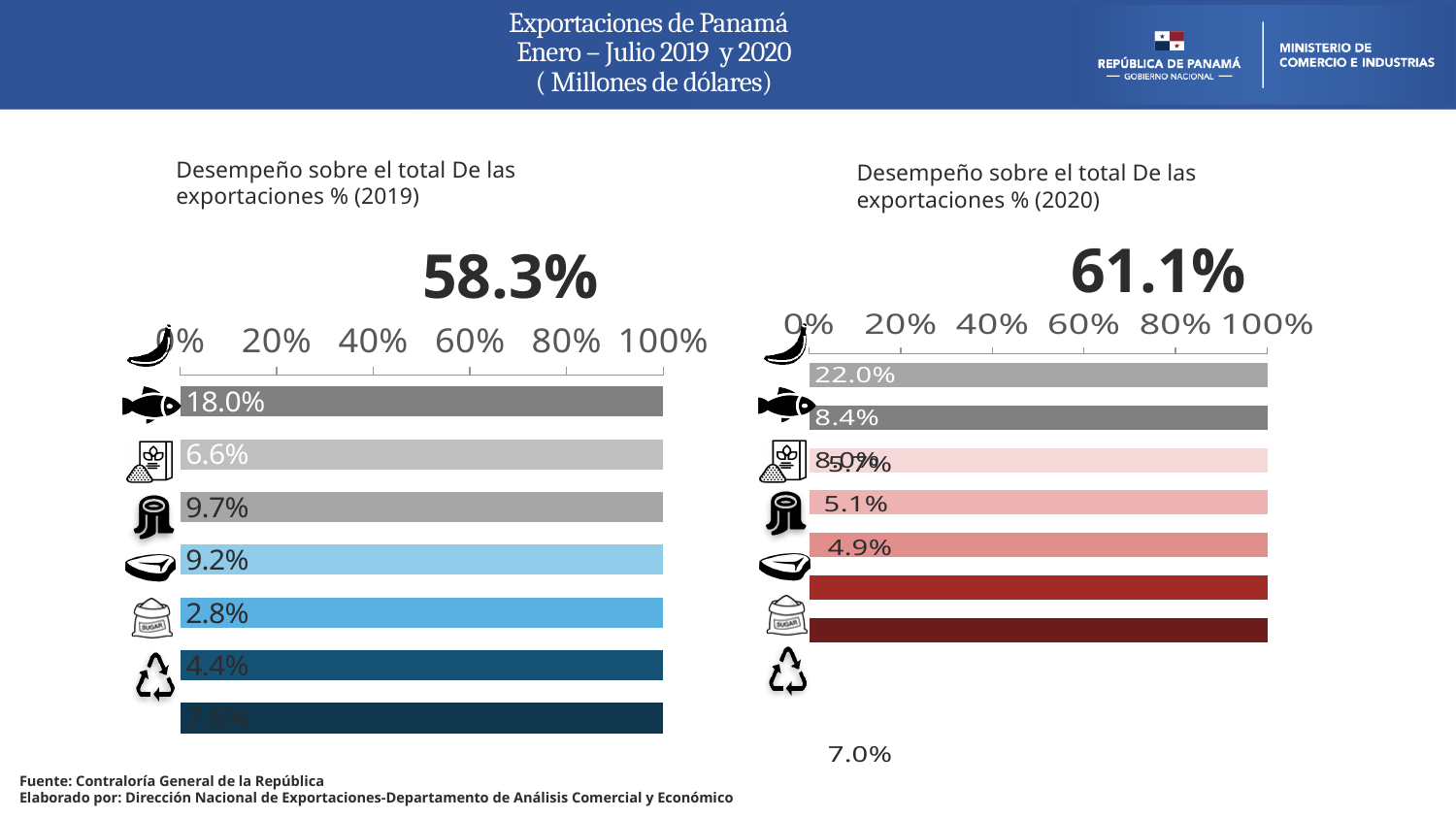
In the 2019 chart on the left, which bar has the lowest labelled value? the bar next to the sugar sack icon, 2.8% In the 2020 chart on the right, what is the data label on the second bar from the top? 8.4% In the 2019 chart on the left, what is the data label on the bar next to the sugar sack icon? 2.8% In the 2019 chart on the left, what is the data label on the topmost bar? 18.0% In the 2020 chart on the right, what is the data label on the topmost bar? 22.0% What kind of chart is used on the left side of the slide for 'Desempeño sobre el total De las exportaciones % (2019)'? bar chart In the 2019 chart on the left, what is the data label on the bar next to the recycling icon? 4.4% In the 2019 chart on the left, what is the difference between the topmost bar's value (18.0%) and the value next to the sugar sack icon (2.8%)? 15.2 percentage points Which is larger: the topmost bar value in the 2019 chart (18.0%) or the topmost bar value in the 2020 chart (22.0%)? the 2020 value, 22.0% What large percentage figure is shown above the 2019 chart on the left? 58.3% What large percentage figure is shown above the 2020 chart on the right? 61.1% In the 2019 chart on the left, which bar has the highest labelled value? the topmost bar (fish icon), 18.0%